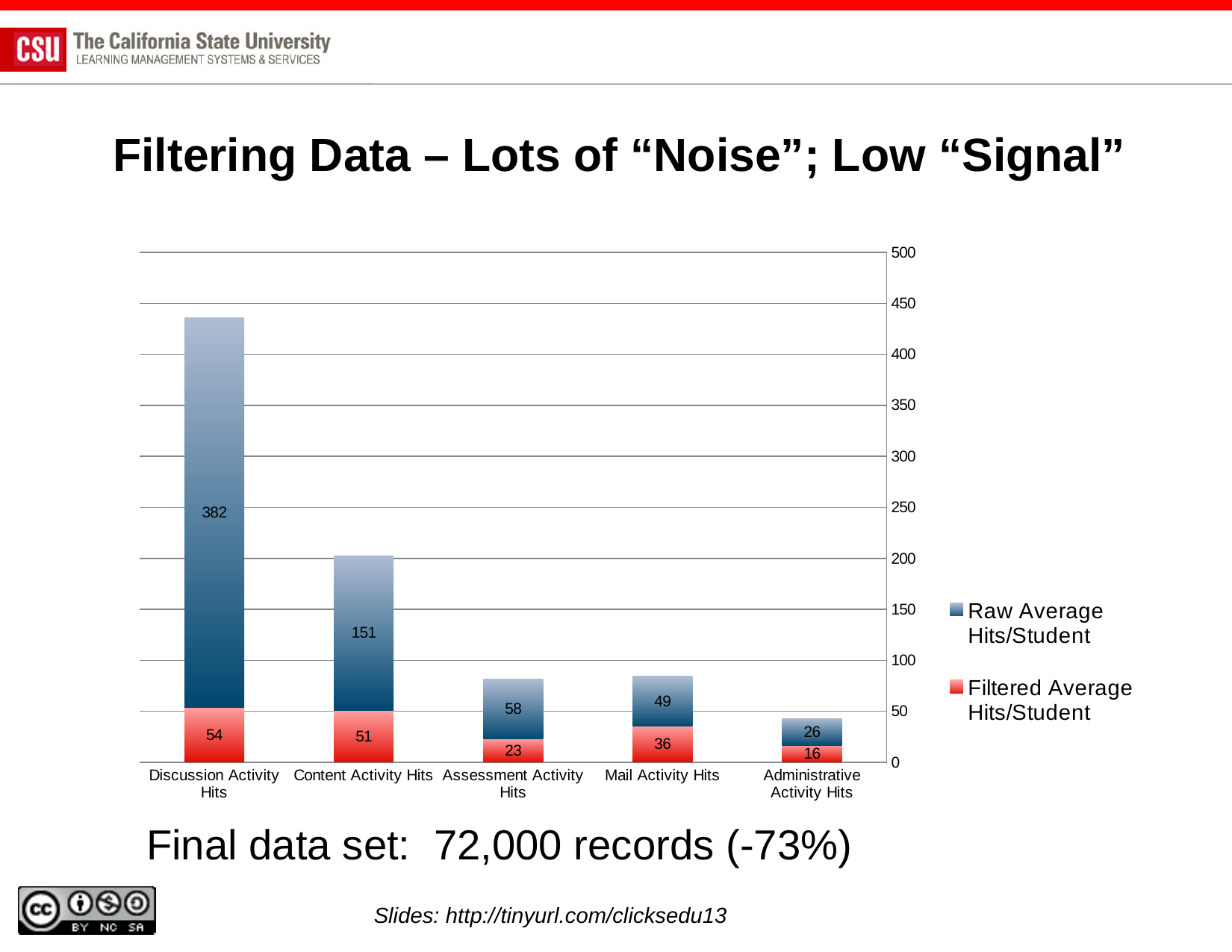
Which is larger, the Raw Average Hits/Student for Assessment Activity Hits or for Mail Activity Hits? Assessment Activity Hits How many series does the legend list? 2 Which category has the lowest Filtered Average Hits/Student? Administrative Activity Hits What is the total height of the stacked bar for Administrative Activity Hits? 42 How many categories are shown on the x axis? 5 What is the Raw Average Hits/Student value for Discussion Activity Hits? 382 Which category has the highest Raw Average Hits/Student? Discussion Activity Hits What kind of chart is shown on the slide? Stacked bar chart What is the difference between the Raw Average Hits/Student and the Filtered Average Hits/Student for Content Activity Hits? 100 What is the Raw Average Hits/Student value for Administrative Activity Hits? 26 What is the total height of the stacked bar for Discussion Activity Hits? 436 What is the Filtered Average Hits/Student value for Mail Activity Hits? 36